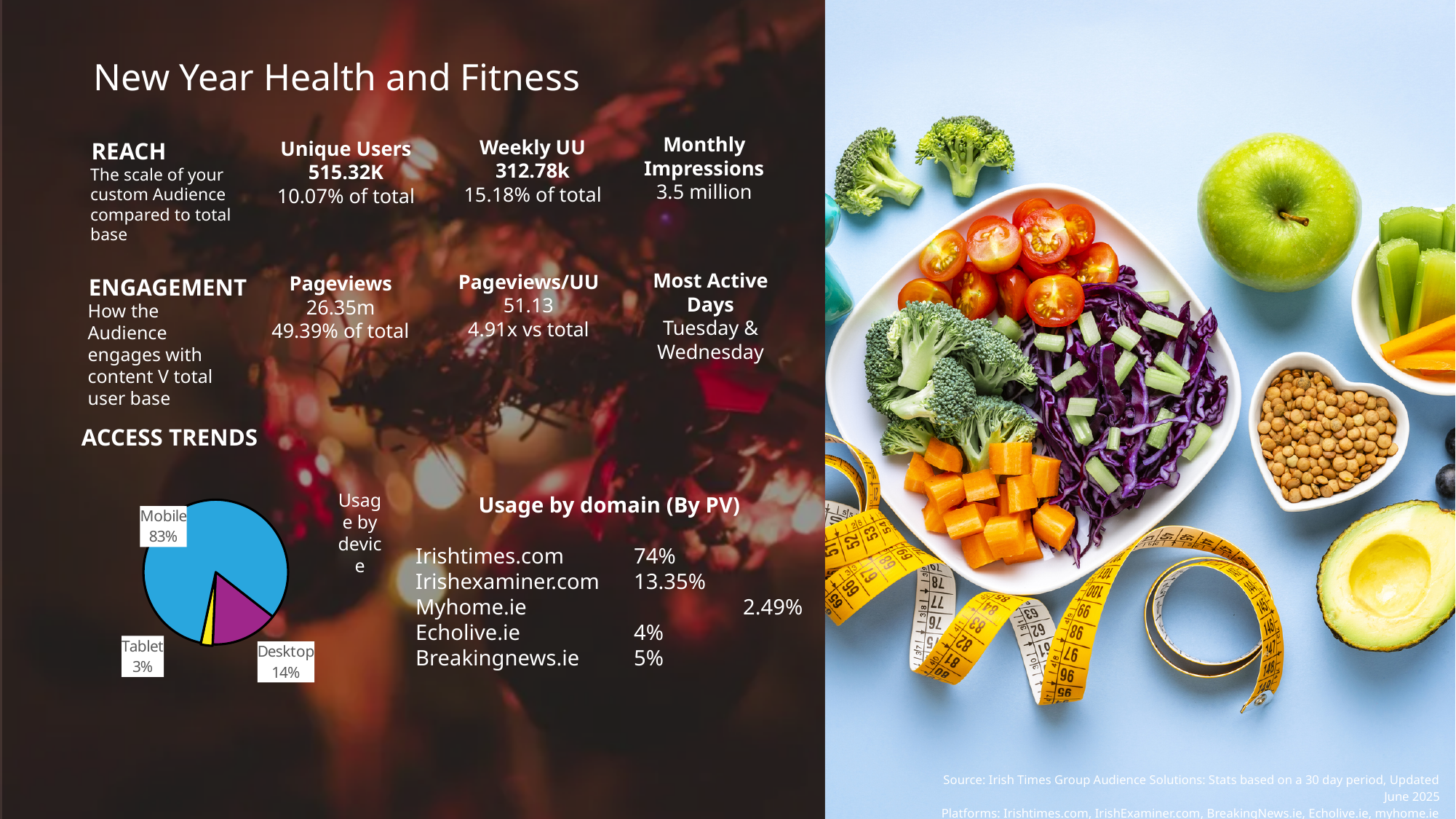
In the "Usage by device" pie chart, which is larger, Desktop or Tablet? Desktop In the "Usage by device" pie chart, what is the difference between the Mobile and Desktop shares? 69% Which device has the largest slice in the "Usage by device" pie chart? Mobile In the "Usage by device" pie chart, what share does Mobile have? 83% What kind of chart is the "Usage by device" chart? pie chart In the "Usage by device" pie chart, what is the difference between the Desktop and Tablet shares? 11% In the "Usage by device" pie chart, what share does Desktop have? 14% In the "Usage by device" pie chart, what colour is the Desktop slice? purple Which device has the smallest slice in the "Usage by device" pie chart? Tablet In the "Usage by device" pie chart, what share does Tablet have? 3% In the "Usage by device" pie chart, what colour is the Mobile slice? blue How many device categories are shown in the "Usage by device" pie chart? 3